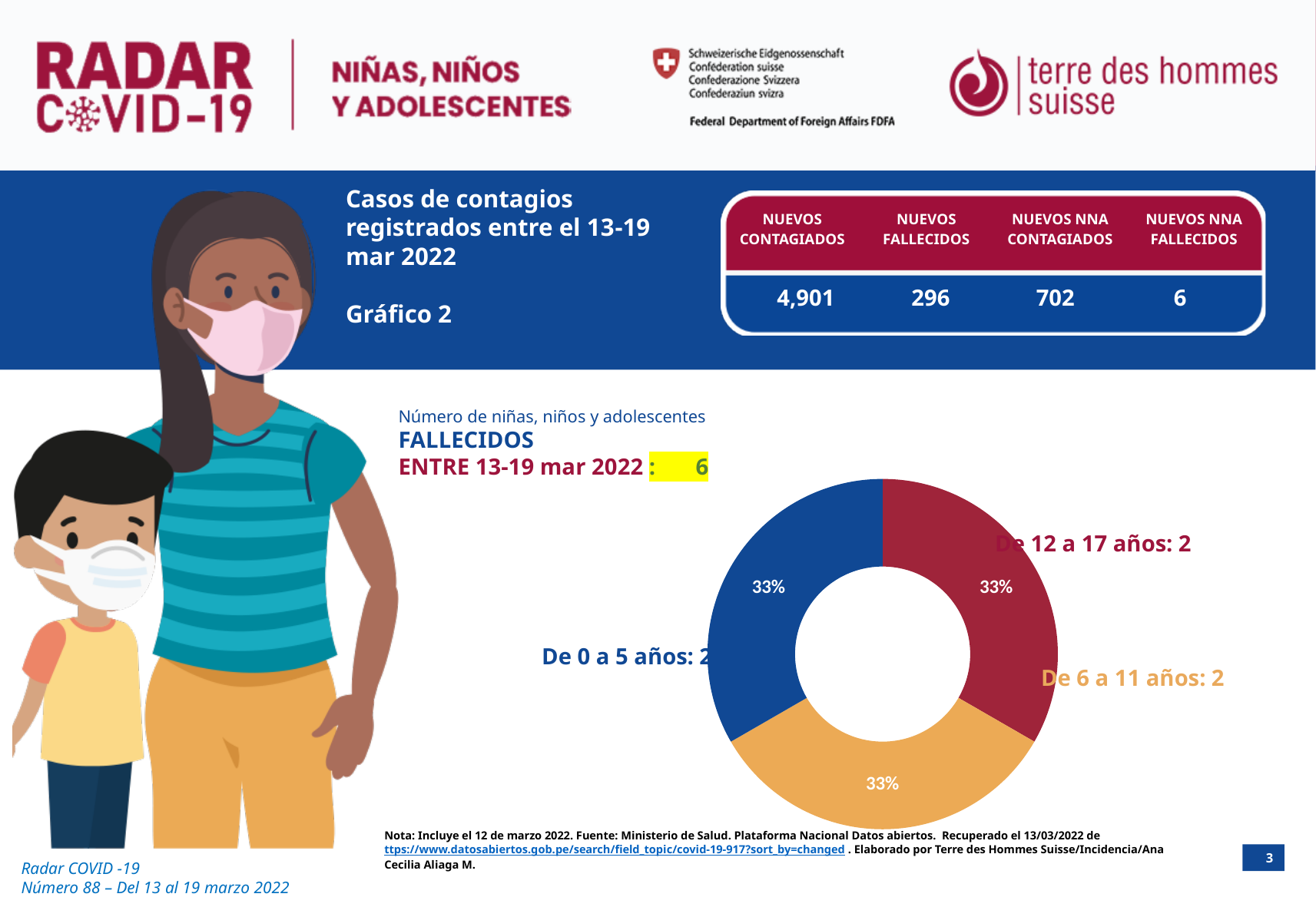
What is the total number of deaths (fallecidos) shown across all three age groups in the donut chart? 6 What share of the donut chart does 'De 6 a 11 años' represent? 33% What is the value for 'De 0 a 5 años' in the donut chart? 2 What is the value for 'De 6 a 11 años' in the donut chart? 2 How many age-group categories does the donut chart show? 3 What share of the donut chart does 'De 12 a 17 años' represent? 33% What is the difference between the values for 'De 0 a 5 años' and 'De 12 a 17 años'? 0 Which colour is used for the 'De 0 a 5 años' slice in the donut chart? Blue What kind of chart is shown on the slide? Pie chart (donut) What is the value for 'De 12 a 17 años' in the donut chart? 2 Which colour is used for the 'De 6 a 11 años' slice in the donut chart? Orange